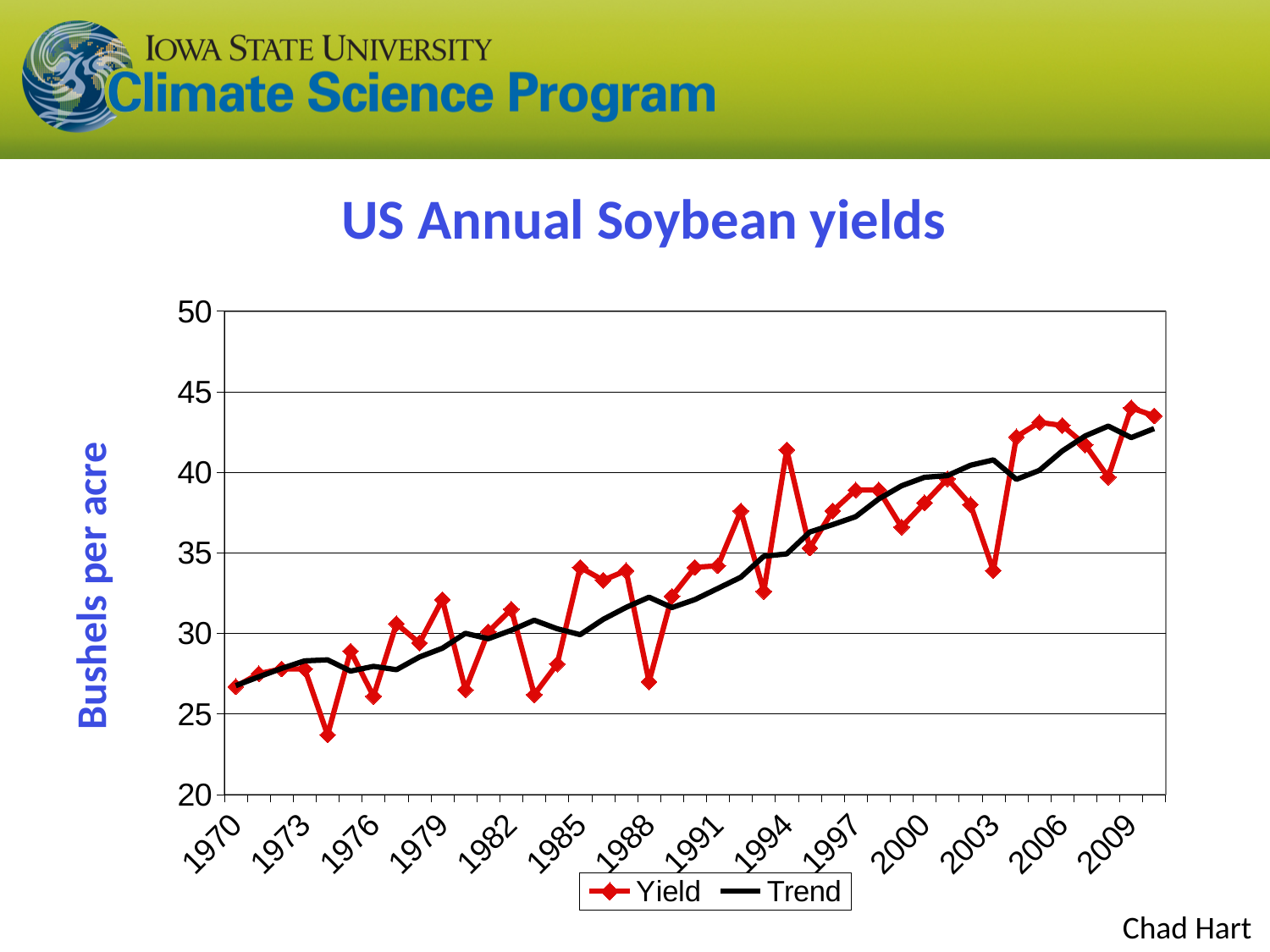
Is the Yield value for 1994 greater or less than 40? greater Which year has the higher Yield value, 1993 or 1994? 1994 Do the Trend values generally rise or fall from 1970 to 2009? rise What is the label on the vertical axis? Bushels per acre Is the Yield value for 1974 greater or less than 25? less What are the two series named in the legend? Yield and Trend What kind of chart is shown on the slide? line chart Is the Yield value for 1970 greater or less than 30? less How many series does the legend list? 2 In which year is the Yield series at its lowest? 1974